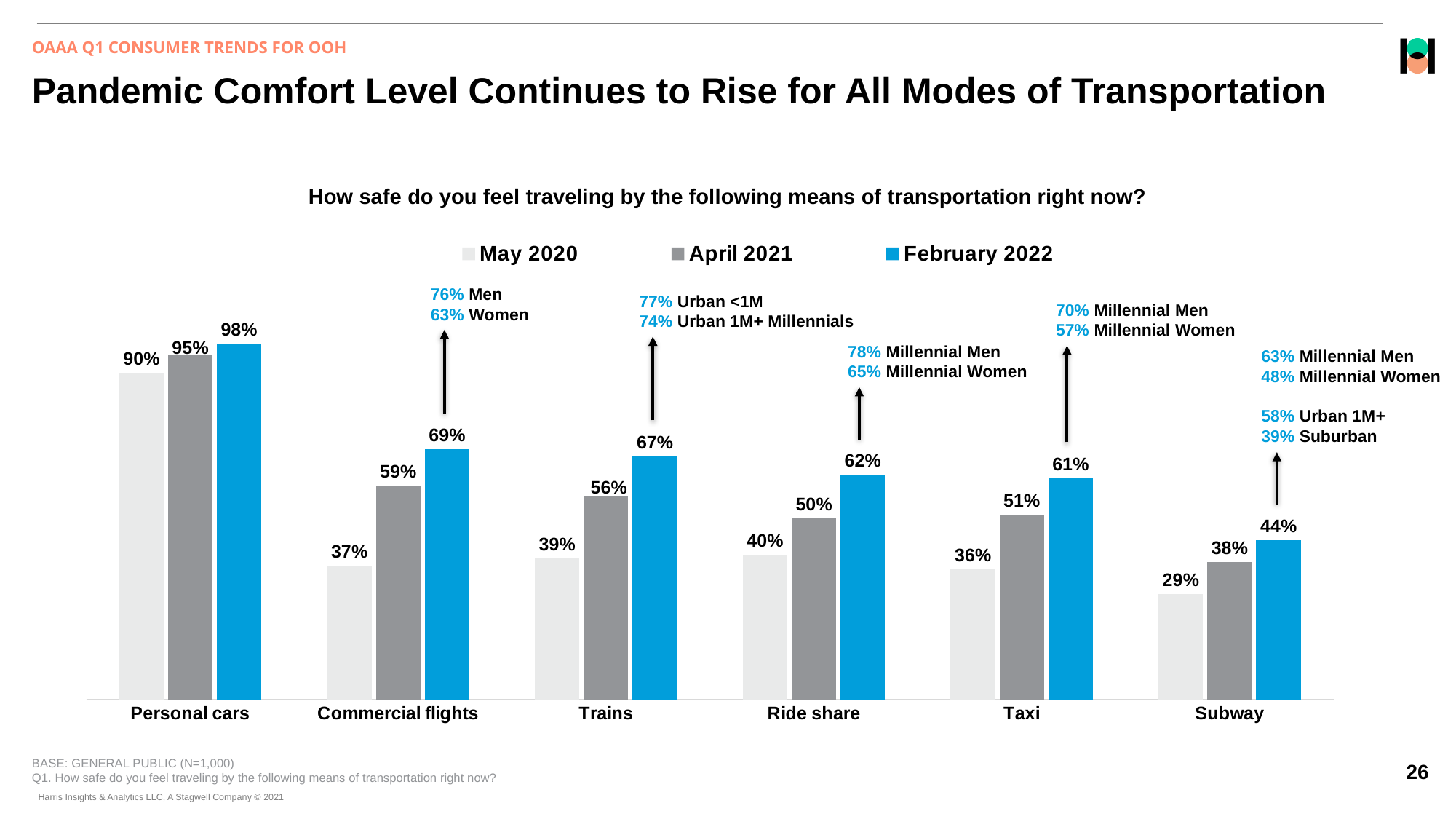
What is the difference between the February 2022 and May 2020 values for Commercial flights? 32% How many modes of transportation are shown on the x axis? 6 For Subway, do the values rise or fall from May 2020 to February 2022? Rise How many series does the legend list? 3 Which mode of transportation has the highest February 2022 value? Personal cars What is the February 2022 value for Personal cars? 98% Which series is shown in blue in the legend? February 2022 What is the May 2020 value for Subway? 29% What is the April 2021 value for Ride share? 50% Which mode of transportation has the lowest May 2020 value? Subway What kind of chart is shown on the slide? Bar chart Which is larger, the February 2022 value for Trains or the February 2022 value for Taxi? Trains